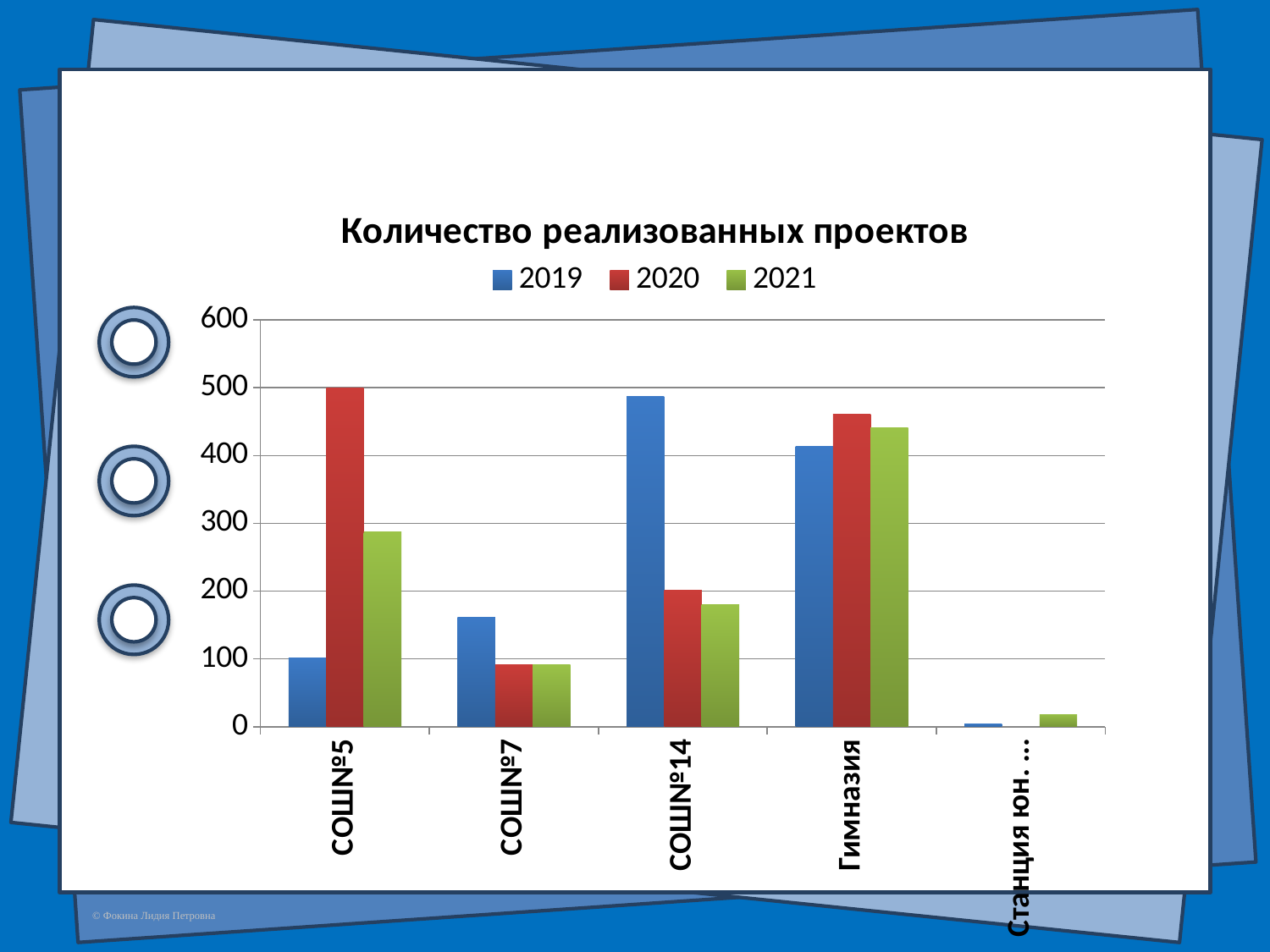
What kind of chart is shown on the slide? bar chart How many series does the legend list? 3 Among СОШ№5, СОШ№7, СОШ№14 and Гимназия, which has the lowest value for 2021? СОШ№7 How many categories are shown on the x axis? 5 Which category has the highest value for 2020? СОШ№5 Which is larger: the 2021 value for СОШ№5 or the 2021 value for СОШ№14? СОШ№5 What is the value for 2020 at СОШ№5? 500 Which category has the highest value for 2019? СОШ№14 What is the title of the chart? Количество реализованных проектов Is the value for 2020 at СОШ№7 greater or less than 100? less Is the value for 2021 at Гимназия greater or less than 400? greater Is the value for 2019 at СОШ№14 greater or less than 400? greater